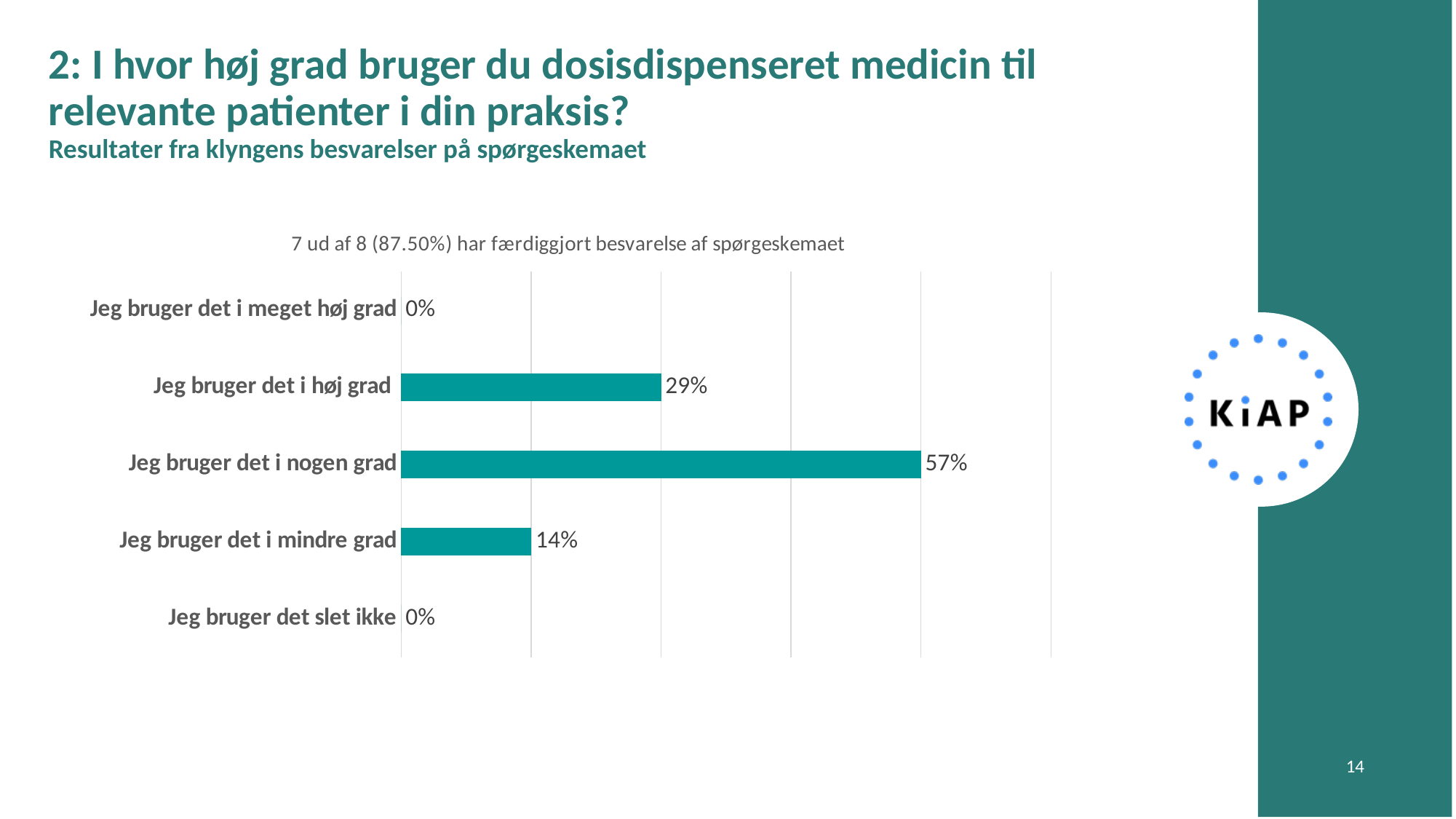
What is the value for "Jeg bruger det i meget høj grad"? 0% What is the value for "Jeg bruger det i nogen grad"? 57% What kind of chart is shown on the slide? Bar chart What is the difference between "Jeg bruger det i nogen grad" and "Jeg bruger det i høj grad"? 28% What is the value for "Jeg bruger det i mindre grad"? 14% According to the text above the chart, how many out of 8 completed the questionnaire? 7 ud af 8 (87.50%) What is the value for "Jeg bruger det slet ikke"? 0% How many categories are shown in the chart? 5 What is the difference between "Jeg bruger det i høj grad" and "Jeg bruger det i mindre grad"? 15% Which is larger: "Jeg bruger det i høj grad" or "Jeg bruger det i mindre grad"? Jeg bruger det i høj grad What is the value for "Jeg bruger det i høj grad"? 29% Which category has the highest value? Jeg bruger det i nogen grad